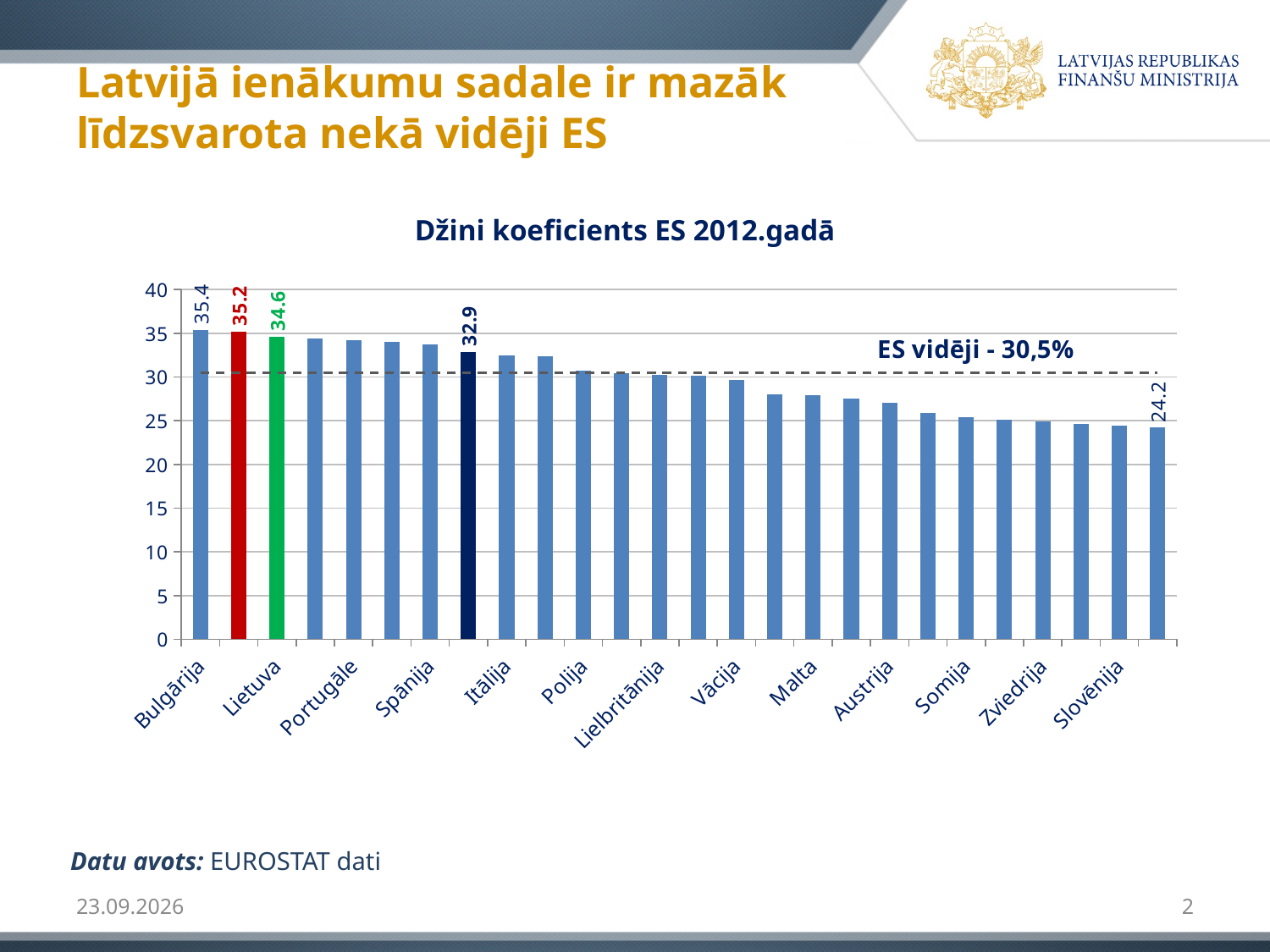
What is the Gini coefficient value shown for Lietuva? 34.6 What is the lowest value shown in the chart? 24.2 Which has a higher Gini coefficient, Bulgārija or Lietuva? Bulgārija What value is shown for the red bar? 35.2 Which country has the highest Gini coefficient in the chart? Bulgārija What is the difference between the values for Bulgārija and Lietuva? 0.8 Is the value for Malta greater or less than 30? less What type of chart is shown on the slide? bar chart What is the title of the chart? Džini koeficients ES 2012.gadā What is the Gini coefficient value shown for Bulgārija? 35.4 Do the values rise or fall from left to right along the x axis? fall What is the EU average (ES vidēji) indicated by the dashed line? 30,5%